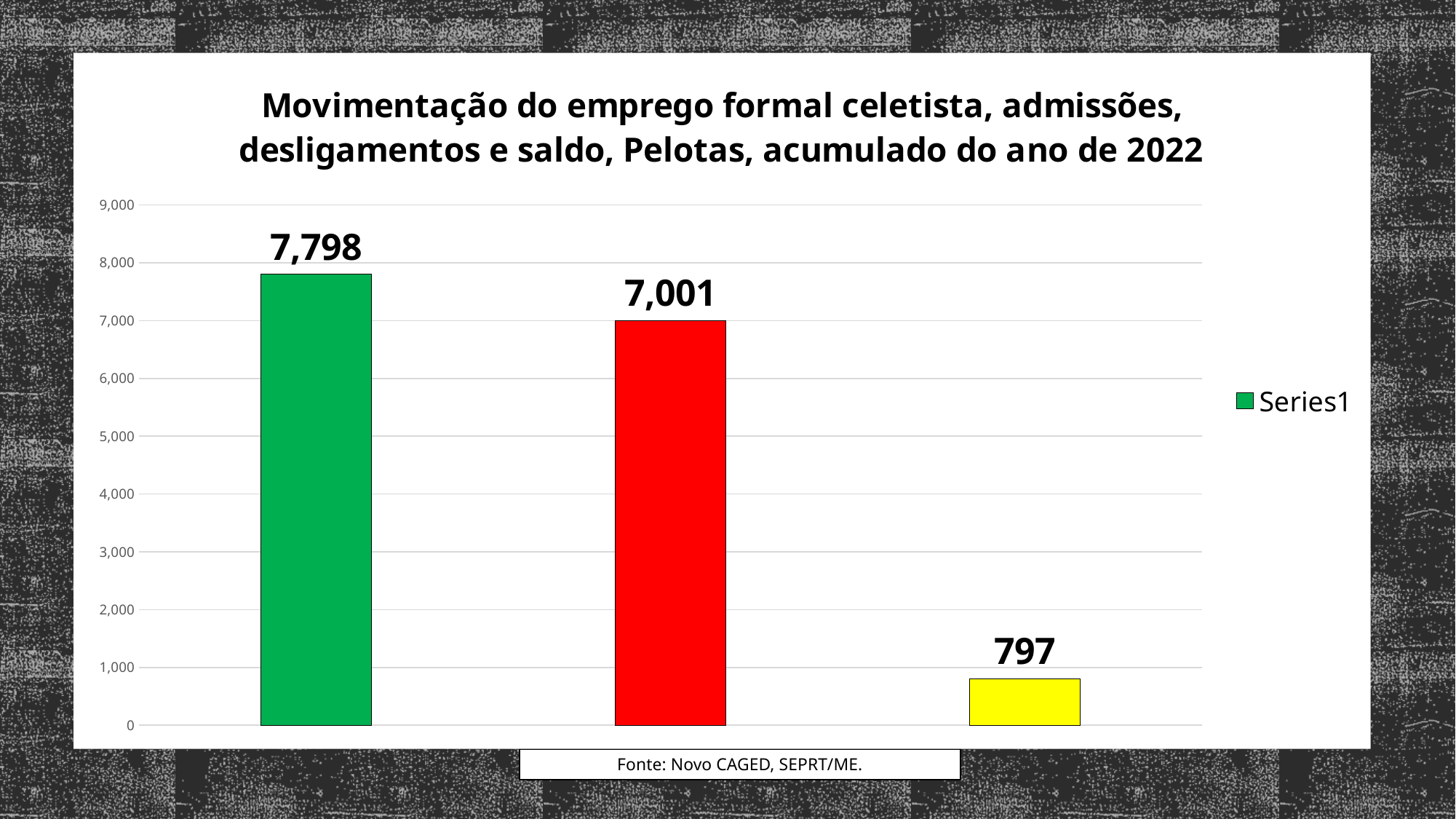
How many bars are plotted in the chart? 3 How many series does the legend list? 1 What value is shown on the yellow (rightmost) bar? 797 What value is shown on the red (middle) bar? 7,001 Which bar has the highest value: the green, red or yellow one? green What is the name of the series shown in the legend? Series1 Is the value of the yellow bar greater or less than 1,000? less What is the difference between the green bar (7,798) and the red bar (7,001)? 797 What value is shown on the green (first) bar? 7,798 Is the value of the green bar larger or smaller than the value of the red bar? larger What kind of chart is shown on the slide? bar chart Which bar has the lowest value: the green, red or yellow one? yellow